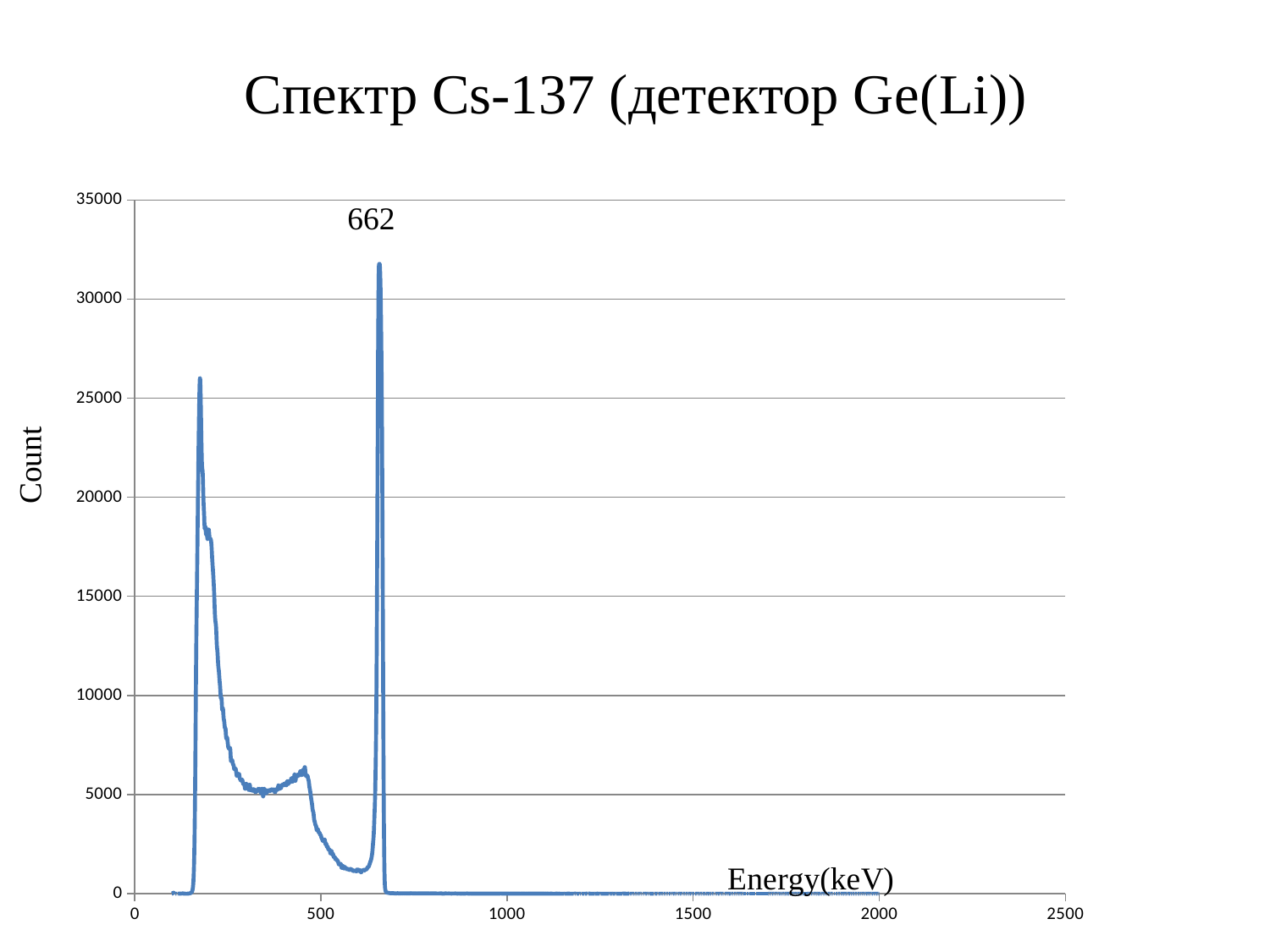
What is the title of the chart? Спектр Cs-137 (детектор Ge(Li)) What label is printed next to the tallest peak of the spectrum? 662 What kind of chart is shown on the slide? line chart Is the count at the peak labelled 662 greater or less than 35000? less What is the highest value shown on the horizontal axis? 2500 Is the count at the peak labelled 662 greater or less than 30000? greater Which peak is higher: the one near 200 keV or the one labelled 662? the one labelled 662 Is the count at the first peak (near 200 keV) greater or less than 20000? greater What is the label of the vertical axis? Count What is the highest value shown on the vertical axis? 35000 How does the count behave along the x axis for energies above 1000 keV? stays flat near 0